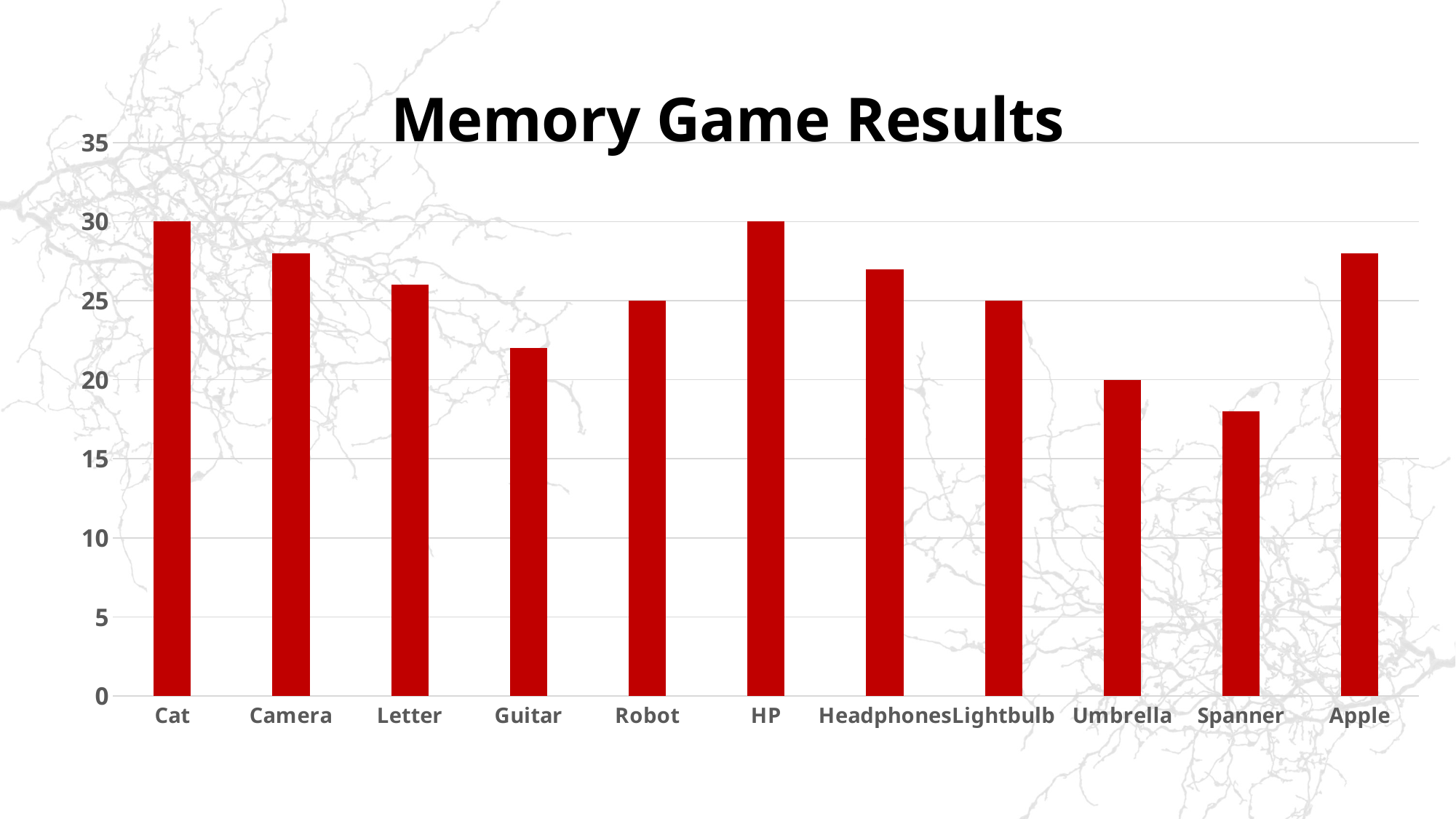
What is the value for Umbrella? 20 How many categories are shown on the x axis? 11 Is the value for Camera greater or less than 25? greater Is the value for Spanner greater or less than 20? less What kind of chart is shown on the slide? bar chart What is the difference between the values for Cat and Umbrella? 10 What is the value for HP? 30 What is the value for Cat? 30 Which is larger, the value for Guitar or the value for Robot? Robot What is the value for Robot? 25 What is the title of the chart? Memory Game Results Which category has the lowest value? Spanner